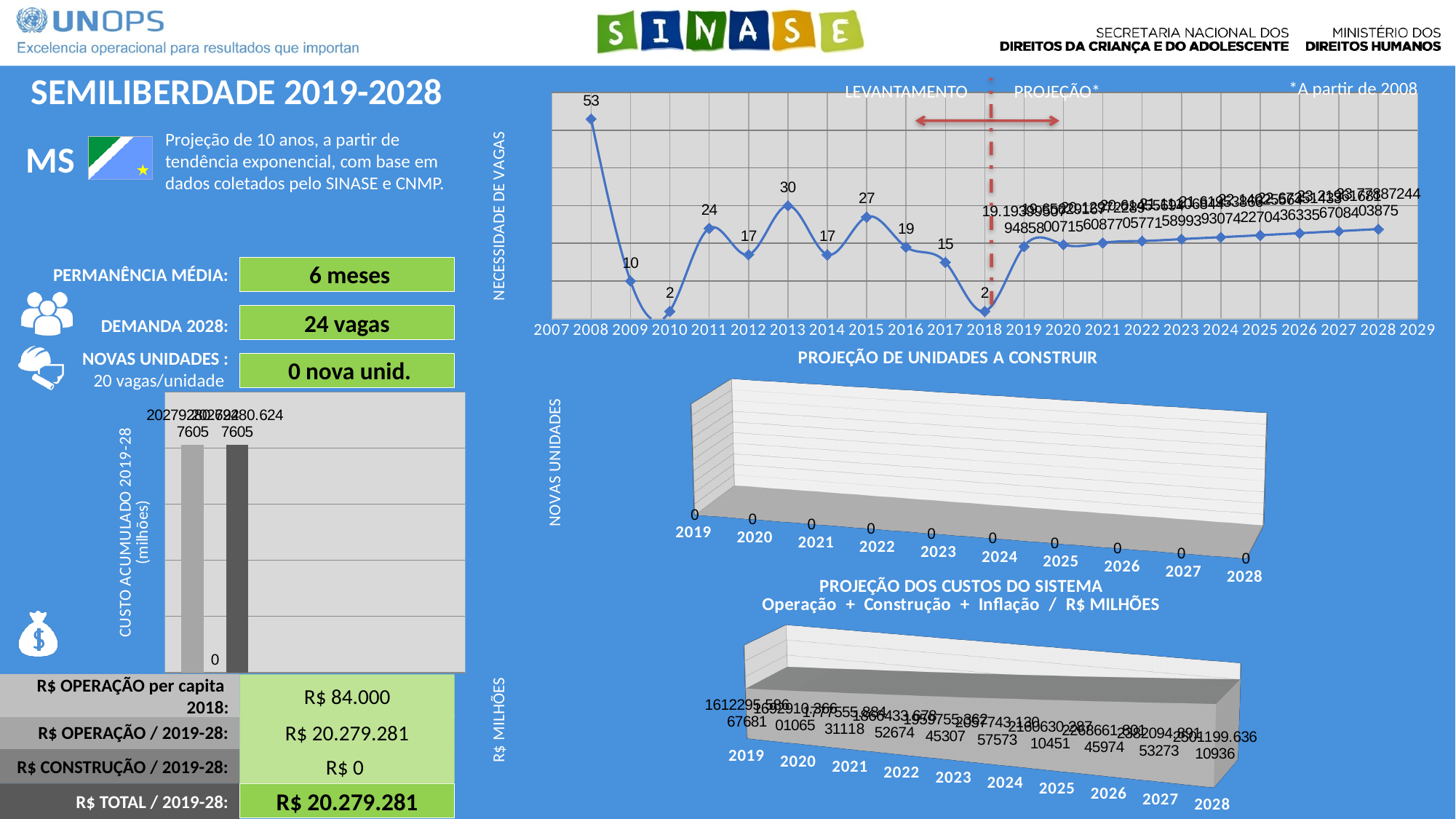
In the top-right line chart (NECESSIDADE DE VAGAS), what is the value for 2017? 15 How many years are shown on the x axis of the chart titled PROJEÇÃO DE UNIDADES A CONSTRUIR? 10 In the top-right line chart (NECESSIDADE DE VAGAS), do the values rise or fall from 2008 to 2010? fall In the top-right line chart (NECESSIDADE DE VAGAS), what is the value for 2008? 53 What kind of chart is the top-right chart labelled NECESSIDADE DE VAGAS? line chart In the top-right line chart (NECESSIDADE DE VAGAS), what is the difference between the values for 2008 and 2009? 43 In the chart titled PROJEÇÃO DE UNIDADES A CONSTRUIR, what is the value for 2025? 0 In the top-right line chart (NECESSIDADE DE VAGAS), which year has the highest value? 2008 In the top-right line chart (NECESSIDADE DE VAGAS), what is the value for 2011? 24 What kind of chart is the chart titled PROJEÇÃO DOS CUSTOS DO SISTEMA? 3D area chart In the top-right line chart (NECESSIDADE DE VAGAS), which is larger, the value for 2013 or the value for 2015? 2013 In the top-right line chart (NECESSIDADE DE VAGAS), what is the value for 2013? 30